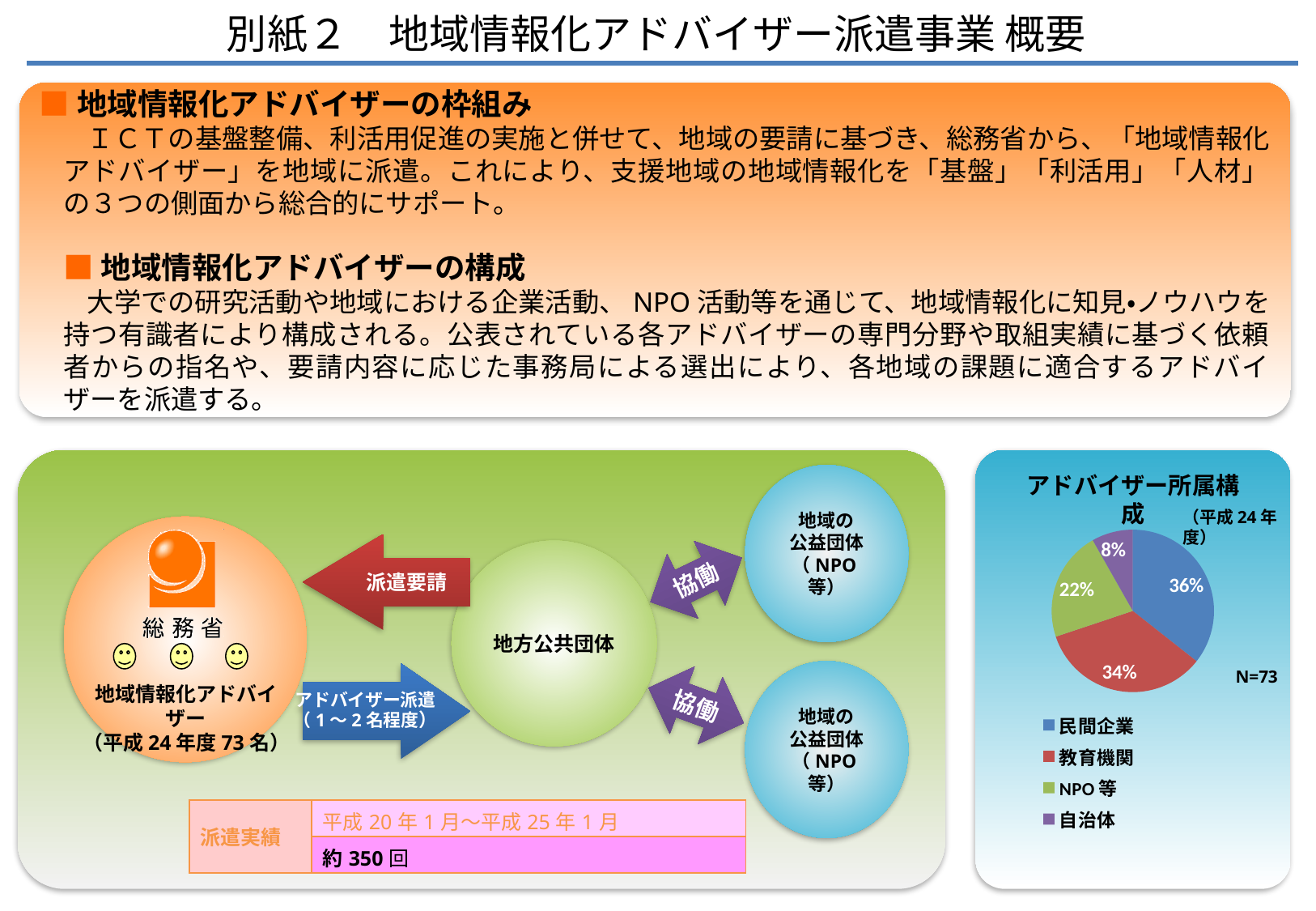
In the pie chart アドバイザー所属構成, what is the difference in percentage points between 教育機関 and NPO等? 12 In the pie chart アドバイザー所属構成, what is the difference in percentage points between 民間企業 and 自治体? 28 Which category has the smallest slice in the pie chart アドバイザー所属構成? 自治体 How many categories does the pie chart アドバイザー所属構成 show? 4 What is the sample size (N) shown next to the pie chart アドバイザー所属構成? N=73 What share of the pie chart アドバイザー所属構成 is 自治体? 8% In the pie chart アドバイザー所属構成, which is larger: NPO等 or 自治体? NPO等 What share of the pie chart アドバイザー所属構成 is NPO等? 22% What kind of chart is アドバイザー所属構成? Pie chart What share of the pie chart アドバイザー所属構成 is 教育機関? 34% What share of the pie chart アドバイザー所属構成 is 民間企業? 36% Which category has the largest slice in the pie chart アドバイザー所属構成? 民間企業